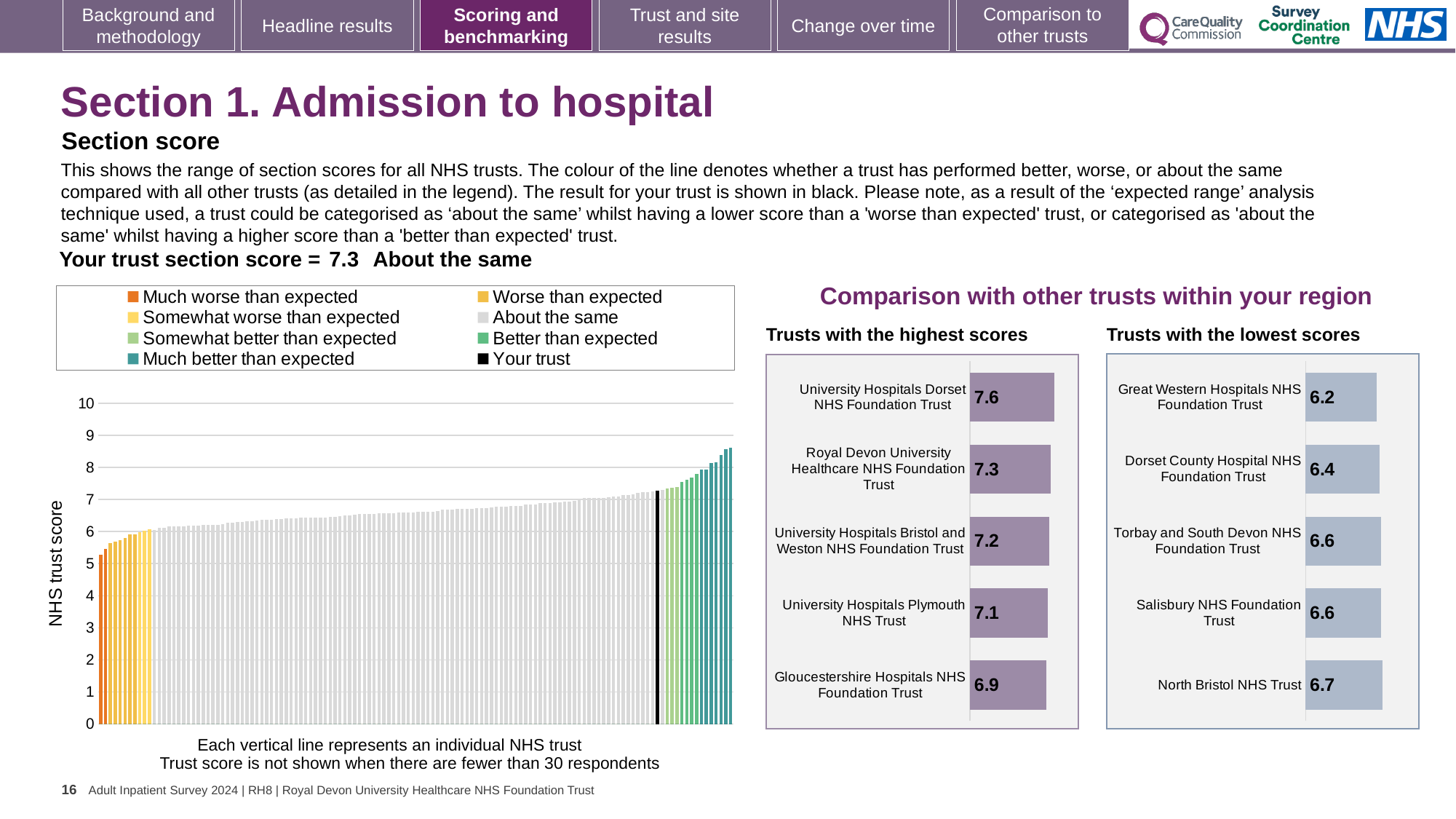
In the 'Trusts with the lowest scores' chart, which has the larger score: Dorset County Hospital NHS Foundation Trust or North Bristol NHS Trust? North Bristol NHS Trust In the 'Trusts with the highest scores' chart, what is the score for Gloucestershire Hospitals NHS Foundation Trust? 6.9 What is the section score for your trust shown on the slide? 7.3 How many entries does the legend of the main chart on the left list? 8 In the 'Trusts with the highest scores' chart, what is the score for University Hospitals Dorset NHS Foundation Trust? 7.6 In the 'Trusts with the highest scores' chart, which trust has the lowest score? Gloucestershire Hospitals NHS Foundation Trust How many trusts are shown in the 'Trusts with the lowest scores' chart? 5 In the 'Trusts with the highest scores' chart, what is the difference between the scores of University Hospitals Dorset NHS Foundation Trust and University Hospitals Plymouth NHS Trust? 0.5 In the main chart of NHS trust scores on the left, is the value of the tallest bar greater or less than 8? greater In the main chart of NHS trust scores on the left, do the values rise or fall from left to right? rise In the 'Trusts with the lowest scores' chart, which trust has the highest score? North Bristol NHS Trust In the 'Trusts with the lowest scores' chart, what is the score for Great Western Hospitals NHS Foundation Trust? 6.2